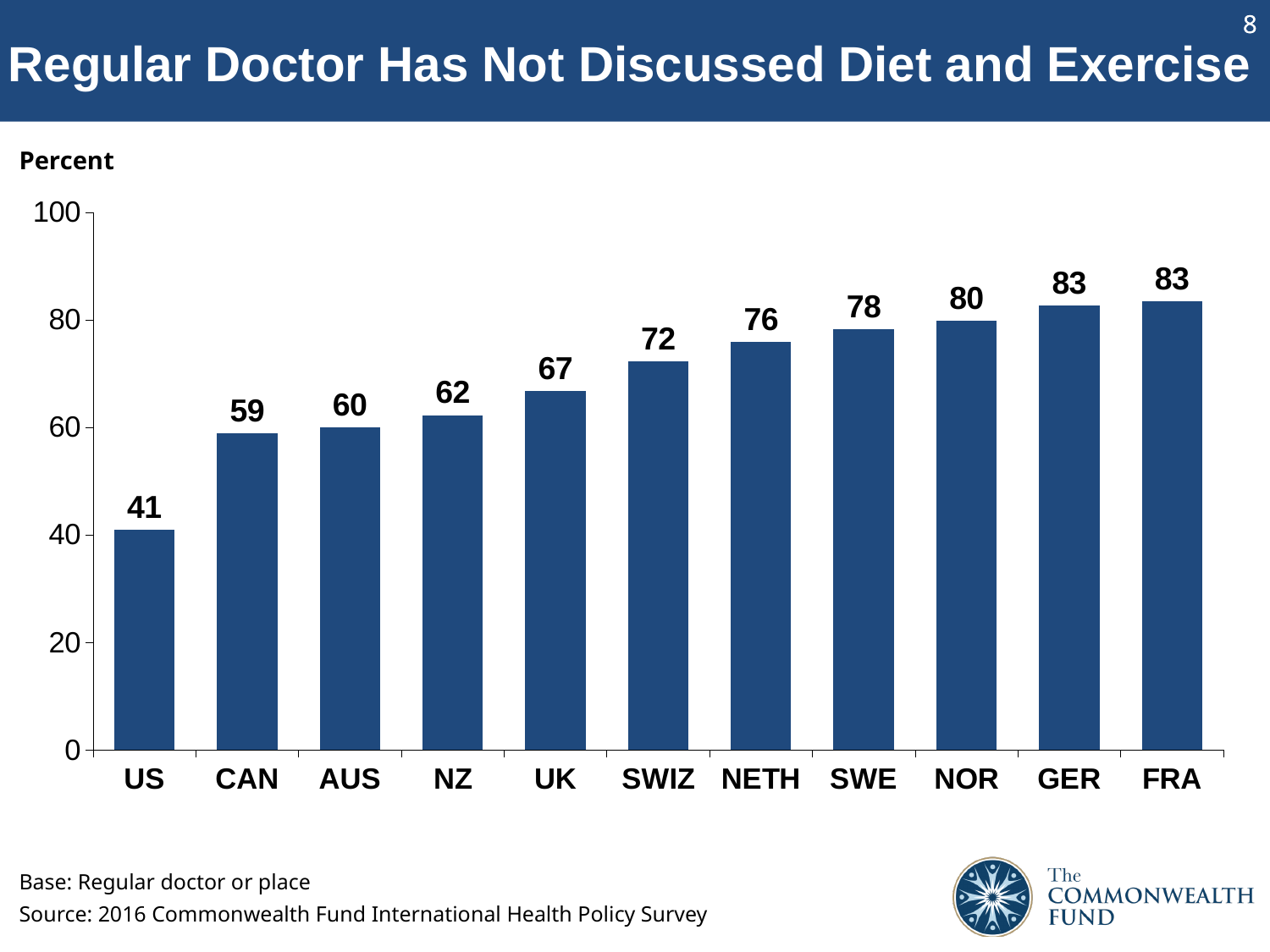
Do the values rise or fall from US to FRA along the x axis? rise What is the difference between the values for NETH and CAN? 17 What is the value for the US? 41 Which country has the lowest value? US What is the title of the chart? Regular Doctor Has Not Discussed Diet and Exercise How many countries are shown on the chart? 11 What is the value for SWIZ? 72 What is the difference between the values for FRA and US? 42 Is the value for SWE greater or less than 60? greater What is the value for NOR? 80 What kind of chart is shown on the slide? bar chart Which is larger, the value for UK or the value for AUS? UK